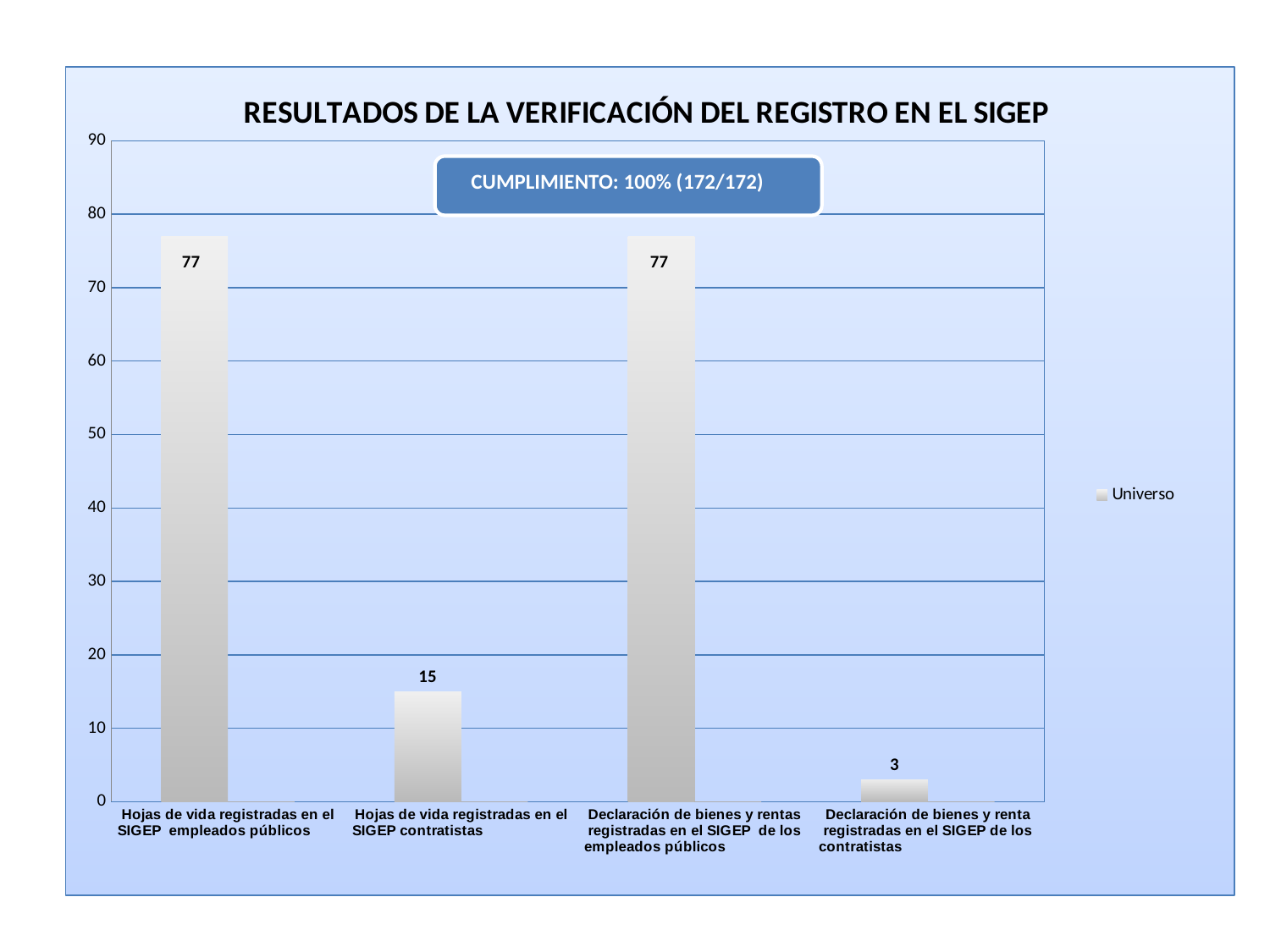
Which is larger: the value for Hojas de vida registradas en el SIGEP contratistas or the value for Declaración de bienes y renta registradas en el SIGEP de los contratistas? Hojas de vida registradas en el SIGEP contratistas Is the value for Declaración de bienes y rentas registradas en el SIGEP de los empleados públicos greater or less than 70? greater Which category has the lowest value? Declaración de bienes y renta registradas en el SIGEP de los contratistas What is the value for Declaración de bienes y renta registradas en el SIGEP de los contratistas? 3 What is the value for Hojas de vida registradas en el SIGEP contratistas? 15 What is the title of the chart? RESULTADOS DE LA VERIFICACIÓN DEL REGISTRO EN EL SIGEP What is the difference between the values for Hojas de vida registradas en el SIGEP empleados públicos and Hojas de vida registradas en el SIGEP contratistas? 62 What is the value for Hojas de vida registradas en el SIGEP empleados públicos? 77 How many series does the legend list? 1 What kind of chart is shown? bar chart How many categories are shown on the x axis? 4 What is the difference between the values for Hojas de vida registradas en el SIGEP contratistas and Declaración de bienes y renta registradas en el SIGEP de los contratistas? 12